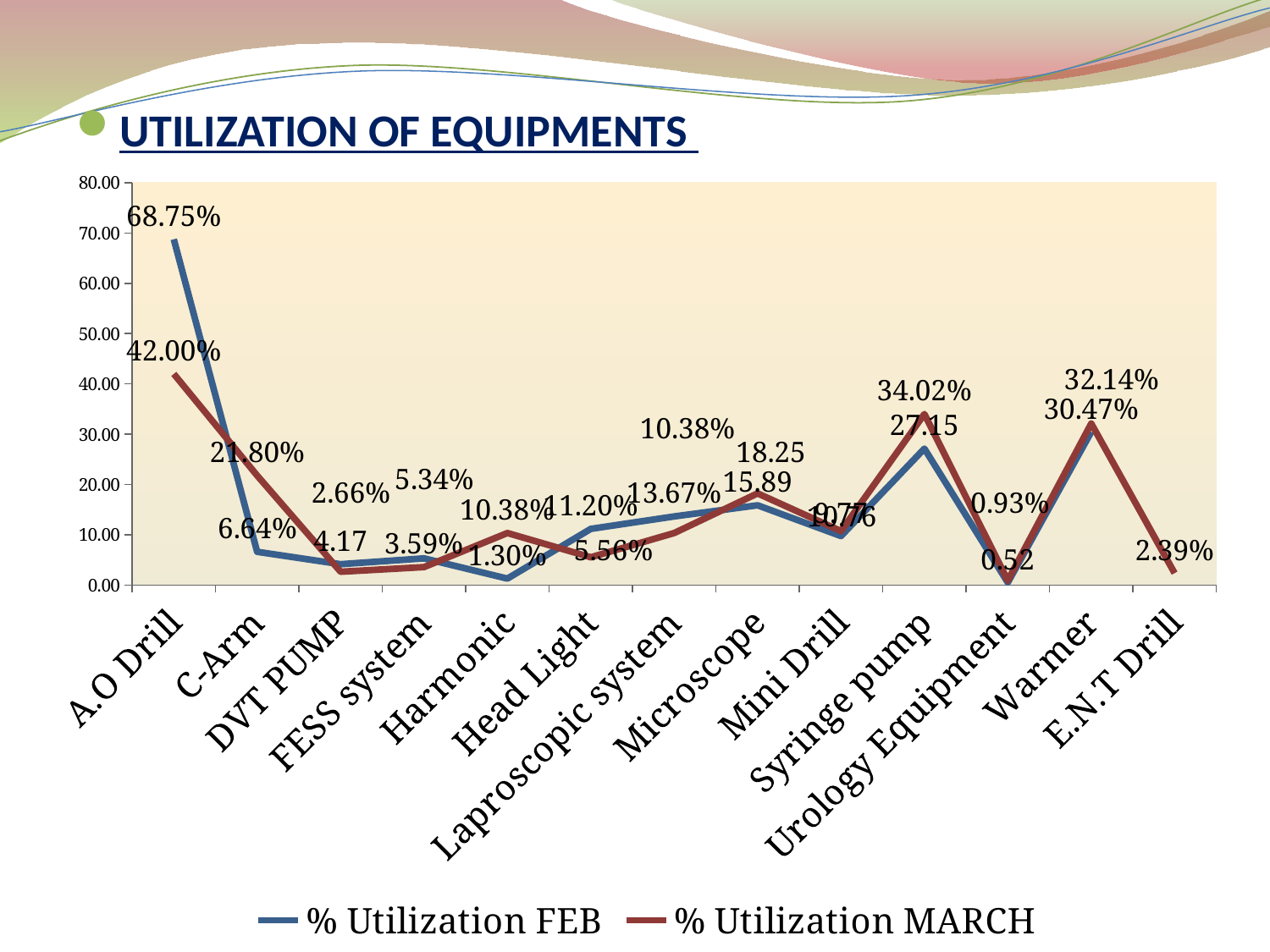
What is the % Utilization MARCH value for Syringe pump? 34.02% What kind of chart is shown on the slide? line chart What is the % Utilization FEB value for A.O Drill? 68.75% Which equipment has the highest % Utilization MARCH? A.O Drill How many series does the legend list? 2 Which equipment has the highest % Utilization FEB? A.O Drill Which equipment has the lowest % Utilization FEB? Urology Equipment For C-Arm, which is larger: % Utilization FEB or % Utilization MARCH? % Utilization MARCH Is the % Utilization FEB value for Syringe pump greater or less than 20? greater What is the difference between % Utilization MARCH and % Utilization FEB for Warmer? 1.67% How many equipment categories are shown on the x axis? 13 What is the % Utilization MARCH value for E.N.T Drill? 2.39%